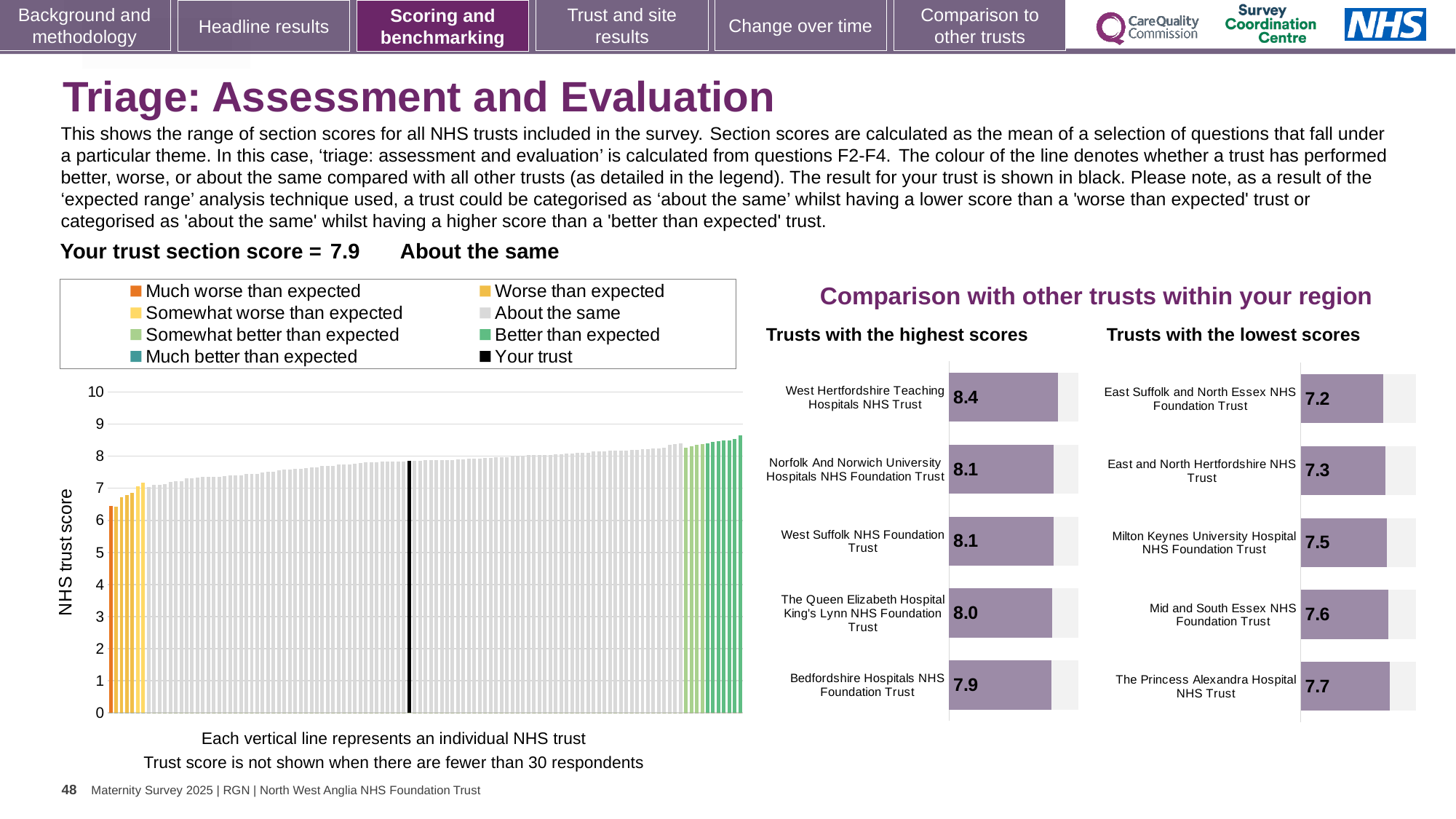
In the 'Trusts with the lowest scores' chart, which has the larger score: East and North Hertfordshire NHS Trust or Mid and South Essex NHS Foundation Trust? Mid and South Essex NHS Foundation Trust In the 'Trusts with the highest scores' chart, what is the score for West Hertfordshire Teaching Hospitals NHS Trust? 8.4 In the 'Trusts with the highest scores' chart, which trust has the lowest score shown? Bedfordshire Hospitals NHS Foundation Trust In the 'Trusts with the highest scores' chart, what is the difference between the scores of West Hertfordshire Teaching Hospitals NHS Trust and Bedfordshire Hospitals NHS Foundation Trust? 0.5 In the 'Trusts with the lowest scores' chart, which trust has the lowest score? East Suffolk and North Essex NHS Foundation Trust How many trusts are listed in the 'Trusts with the highest scores' chart? 5 In the 'Trusts with the lowest scores' chart, what is the difference between the scores of The Princess Alexandra Hospital NHS Trust and East Suffolk and North Essex NHS Foundation Trust? 0.5 What kind of chart is the NHS trust score chart on the left of the slide? Bar chart In the 'Trusts with the lowest scores' chart, what is the score for Milton Keynes University Hospital NHS Foundation Trust? 7.5 In the NHS trust score chart on the left, do the bar values rise or fall from left to right? Rise In the 'Trusts with the lowest scores' chart, which trust has the highest score shown? The Princess Alexandra Hospital NHS Trust How many entries does the legend of the NHS trust score chart on the left list? 8